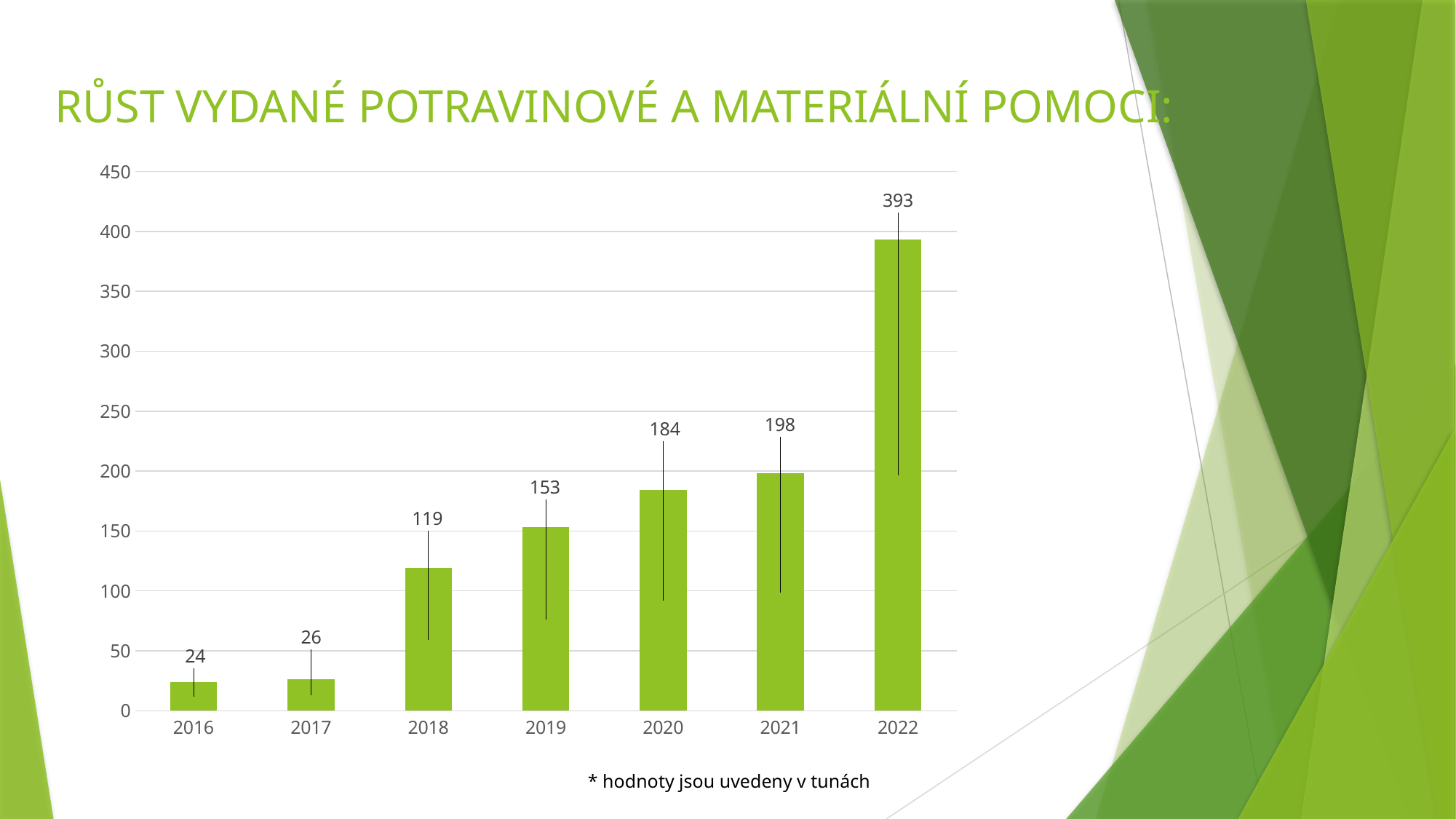
Which is larger, the value for 2020 or the value for 2019? 2020 What is the value for 2016? 24 What is the difference between the values for 2019 and 2018? 34 What is the value for 2022? 393 What is the difference between the values for 2022 and 2021? 195 What is the value for 2018? 119 Do the values rise or fall from 2016 to 2022? rise Which year has the lowest value? 2016 How many years are shown on the x axis? 7 Is the value for 2021 greater or less than 150? greater Which year has the highest value? 2022 What kind of chart is shown on the slide? bar chart